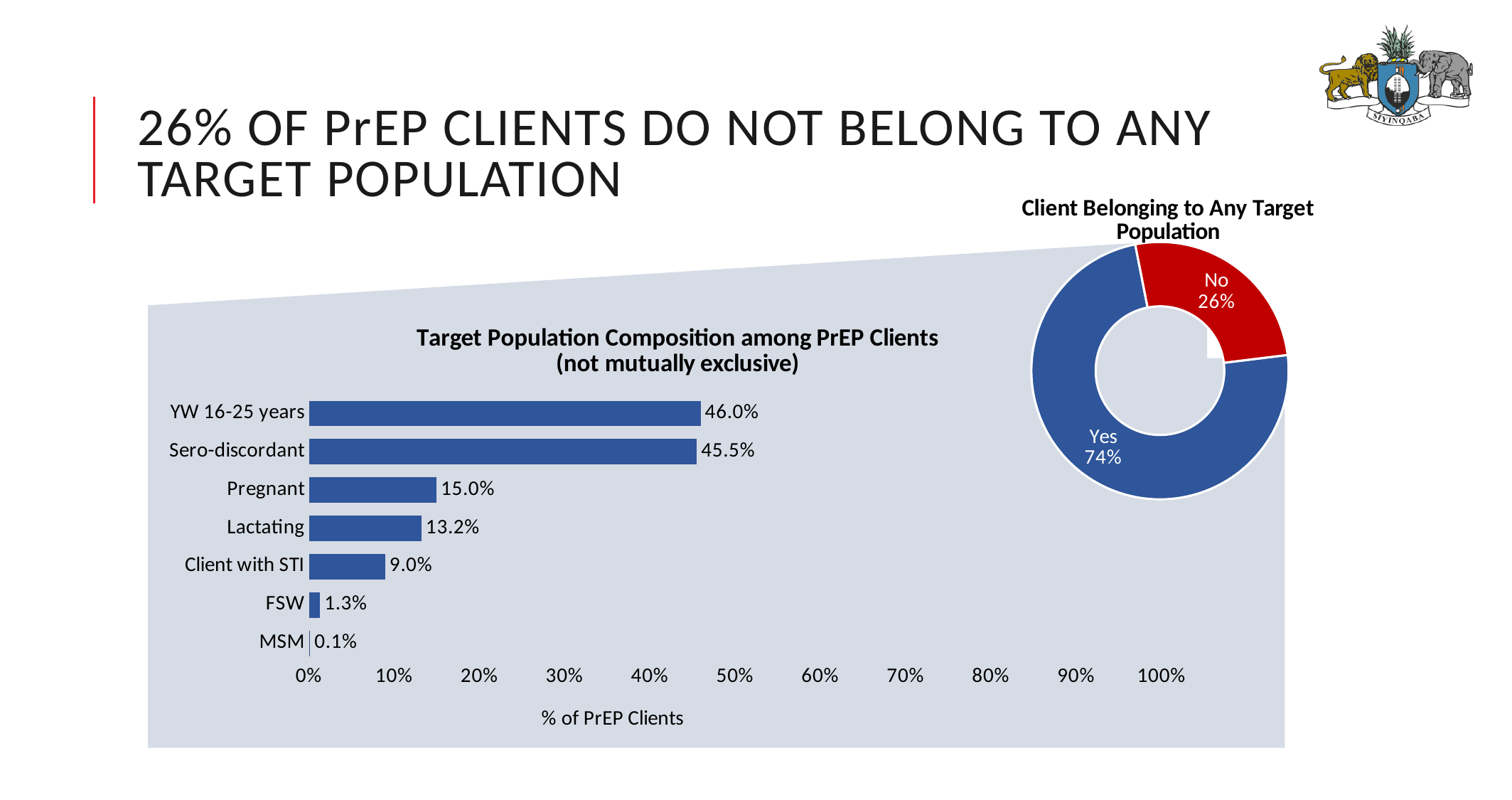
In the 'Target Population Composition among PrEP Clients' chart, what is the value for Client with STI? 9.0% In the 'Target Population Composition among PrEP Clients' chart, which category has the lowest value? MSM What kind of chart is 'Target Population Composition among PrEP Clients'? Bar chart What kind of chart is 'Client Belonging to Any Target Population'? Doughnut chart In the 'Target Population Composition among PrEP Clients' chart, which category has the highest value? YW 16-25 years In the 'Target Population Composition among PrEP Clients' chart, which is larger, the value for Lactating or the value for Client with STI? Lactating What is the x-axis label of the 'Target Population Composition among PrEP Clients' chart? % of PrEP Clients In the 'Target Population Composition among PrEP Clients' chart, how many categories are shown? 7 In the 'Client Belonging to Any Target Population' chart, what share of clients is labelled 'No'? 26% In the 'Client Belonging to Any Target Population' chart, what is the value for 'Yes'? 74% In the 'Target Population Composition among PrEP Clients' chart, what is the difference between the values for Pregnant and Lactating? 1.8% In the 'Target Population Composition among PrEP Clients' chart, what is the value for Pregnant? 15.0%